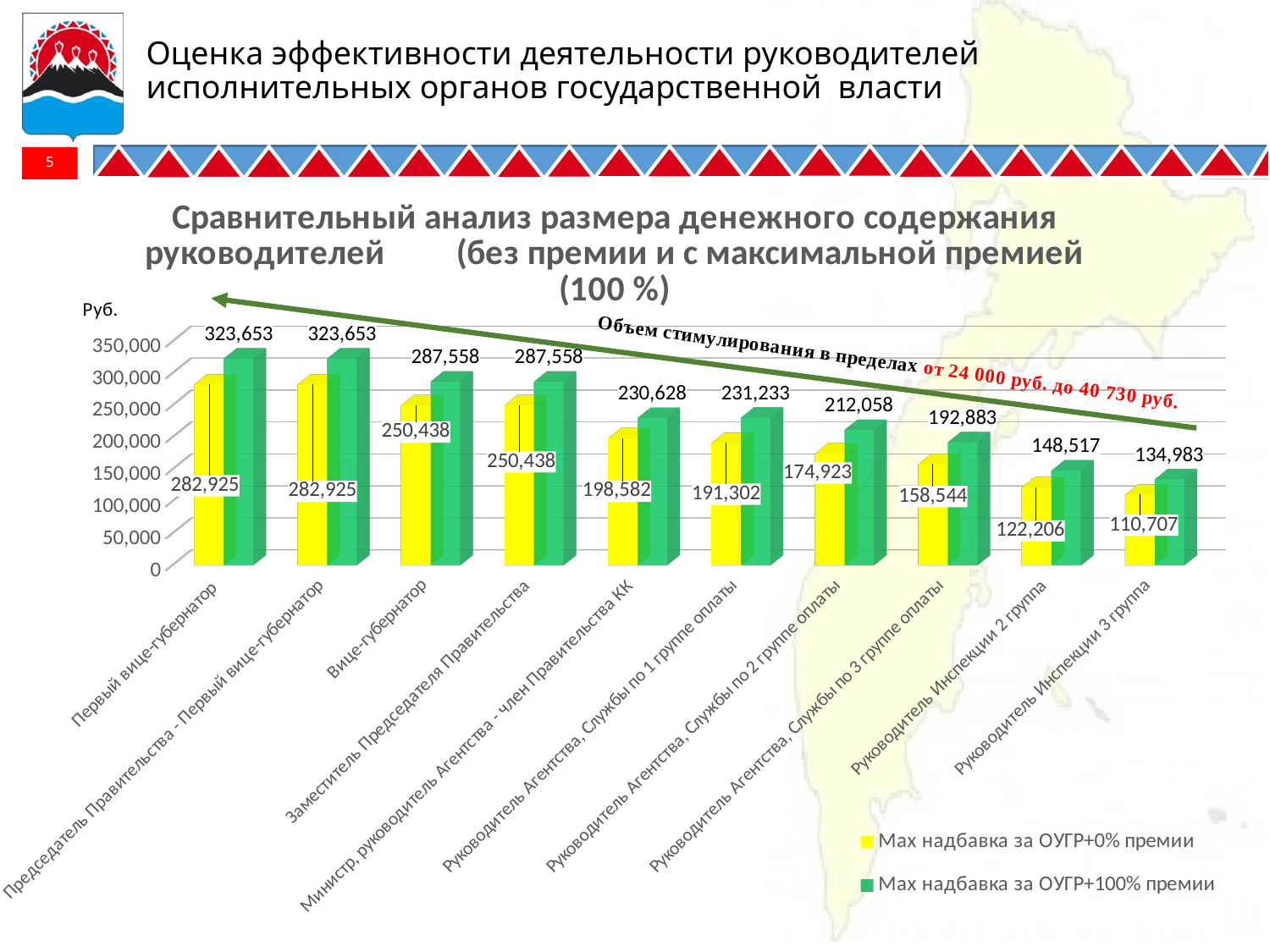
What is the value for Вице-губернатор in the 'Max надбавка за ОУГР+100% премии' series? 287,558 How many categories are shown on the x axis of the chart? 10 What kind of chart is shown on the slide? Bar chart What is the difference between the 'Max надбавка за ОУГР+100% премии' and 'Max надбавка за ОУГР+0% премии' values for Первый вице-губернатор? 40,728 Which category has the lowest value in the 'Max надбавка за ОУГР+0% премии' series? Руководитель Инспекции 3 группа Is the 'Max надбавка за ОУГР+100% премии' value for Руководитель Инспекции 2 группа greater or less than 150,000? less What is the value for Руководитель Инспекции 3 группа in the 'Max надбавка за ОУГР+0% премии' series? 110,707 What is the value for Руководитель Агентства, Службы по 2 группе оплаты in the 'Max надбавка за ОУГР+100% премии' series? 212,058 Do the values in the 'Max надбавка за ОУГР+100% премии' series generally rise or fall from left to right along the x axis? Fall How many series does the chart legend list? 2 What is the difference between the 'Max надбавка за ОУГР+100% премии' and 'Max надбавка за ОУГР+0% премии' values for Руководитель Инспекции 3 группа? 24,276 Which is larger in the 'Max надбавка за ОУГР+0% премии' series: Руководитель Агентства, Службы по 3 группе оплаты or Руководитель Инспекции 2 группа? Руководитель Агентства, Службы по 3 группе оплаты